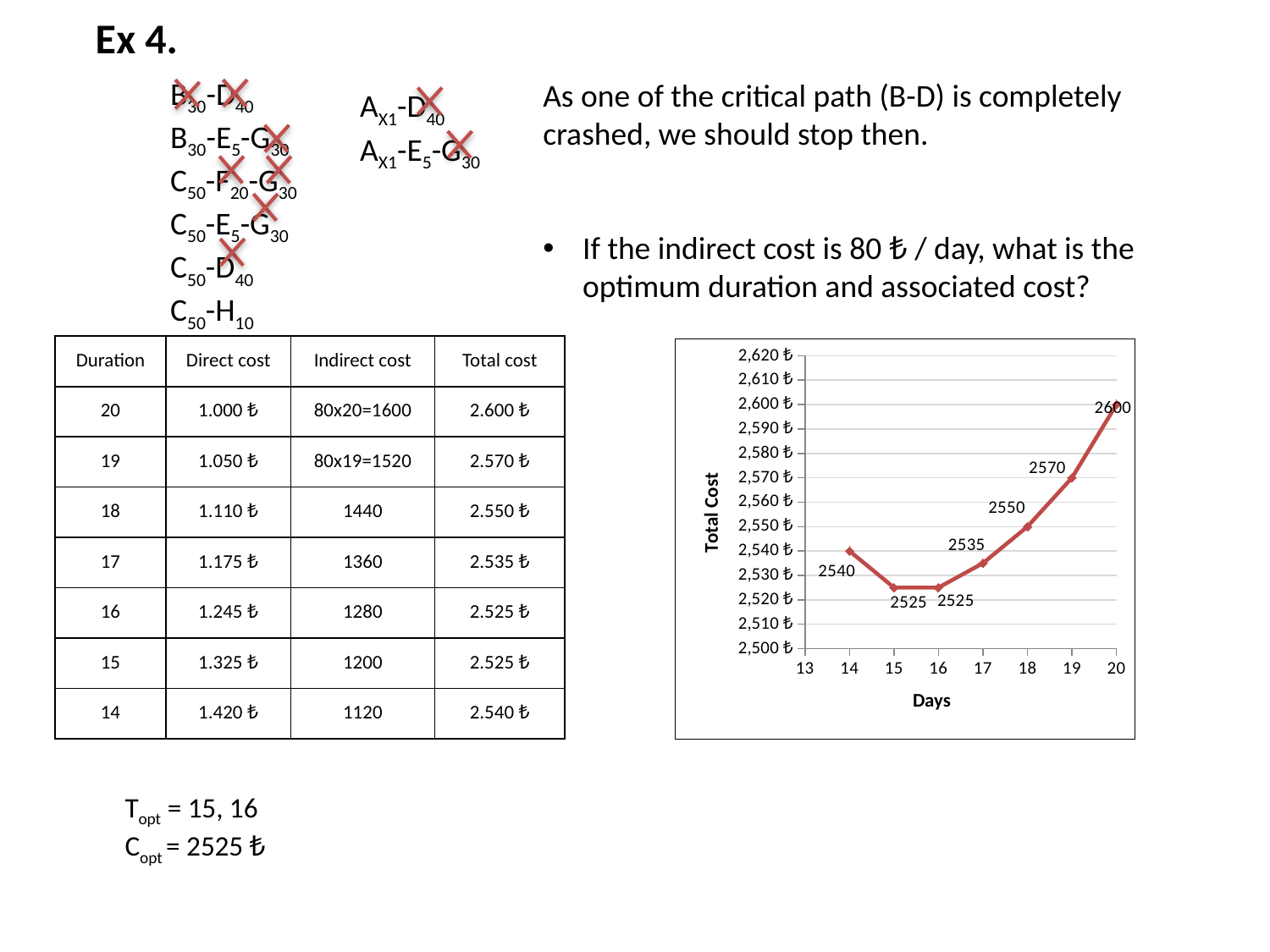
What is the total cost at 20 days? 2600 Does the total cost rise or fall between 16 and 20 days? rise What is the total cost at 18 days? 2550 Which is larger, the total cost at 17 days or at 14 days? 14 days What is the label of the vertical axis of the chart? Total Cost What is the difference between the total cost at 19 days and at 17 days? 35 What is the difference between the total cost at 20 days and at 14 days? 60 How many data points are plotted on the chart? 7 What is the lowest total cost value plotted on the chart? 2525 What type of chart is shown on the slide? line chart At which number of days is the total cost highest? 20 What is the total cost at 14 days? 2540